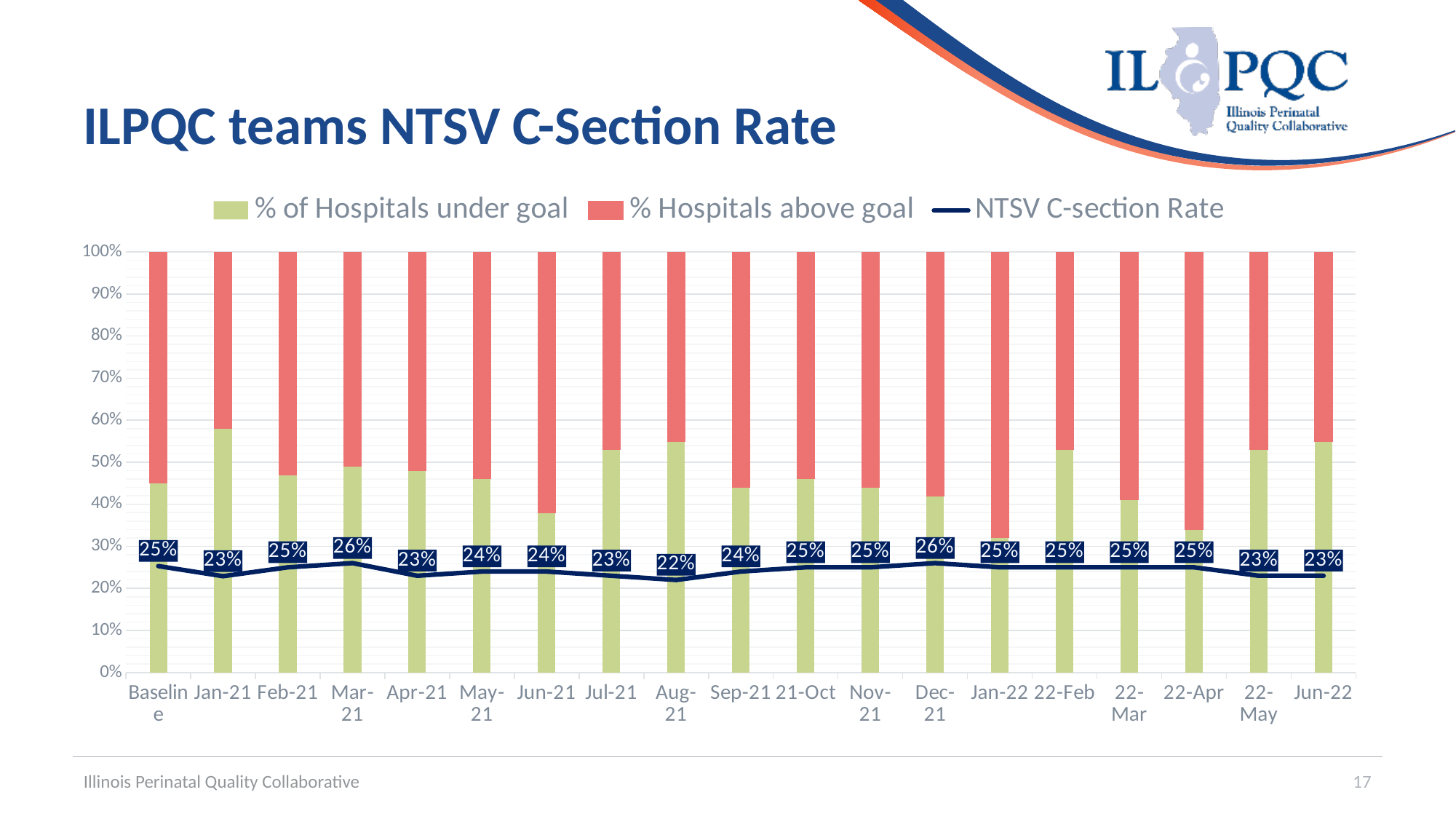
How many series does the legend list? 3 Which month has the lowest NTSV C-section Rate? Aug-21 Which is larger, the NTSV C-section Rate for Jan-21 or for Feb-21? Feb-21 What is the NTSV C-section Rate for Aug-21? 22% How many time periods are shown on the x axis? 19 What is the title of the slide's chart? ILPQC teams NTSV C-Section Rate Is the value for % of Hospitals under goal in Jan-21 greater or less than 50%? greater What is the NTSV C-section Rate for Dec-21? 26% What is the difference between the NTSV C-section Rate for Mar-21 and for Aug-21? 4 percentage points What is the NTSV C-section Rate at Baseline? 25% Is the value for % of Hospitals under goal in Jan-22 greater or less than 40%? less What kind of chart is this? Stacked bar chart with a line